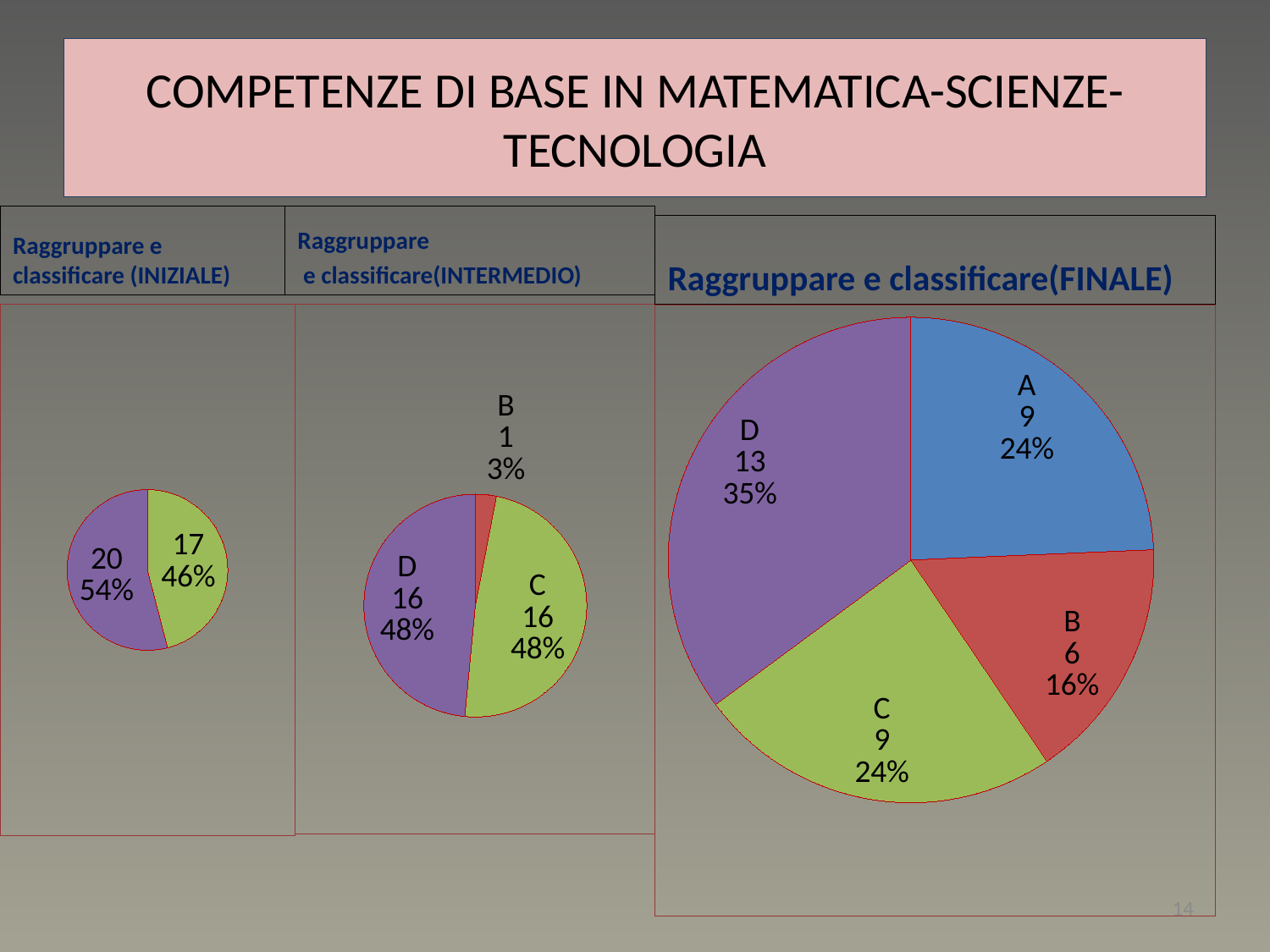
In the 'Raggruppare e classificare (INIZIALE)' chart, what percentage is shown for the slice with value 20? 54% In the 'Raggruppare e classificare(INTERMEDIO)' chart, which category has the smallest slice? B In the 'Raggruppare e classificare(FINALE)' chart, what is the difference between the values for D and B? 7 What type of chart is used for 'Raggruppare e classificare(FINALE)'? Pie chart In the 'Raggruppare e classificare(FINALE)' chart, which category has the largest slice? D In the 'Raggruppare e classificare(INTERMEDIO)' chart, what value is shown for category B? 1 In the 'Raggruppare e classificare(INTERMEDIO)' chart, what percentage is shown for category C? 48% In the 'Raggruppare e classificare(FINALE)' chart, what value is shown for category D? 13 How many slices does the 'Raggruppare e classificare(FINALE)' pie chart have? 4 How many slices does the 'Raggruppare e classificare (INIZIALE)' pie chart have? 2 In the 'Raggruppare e classificare(FINALE)' chart, which category has the smallest slice? B In the 'Raggruppare e classificare(FINALE)' chart, what percentage is shown for category B? 16%